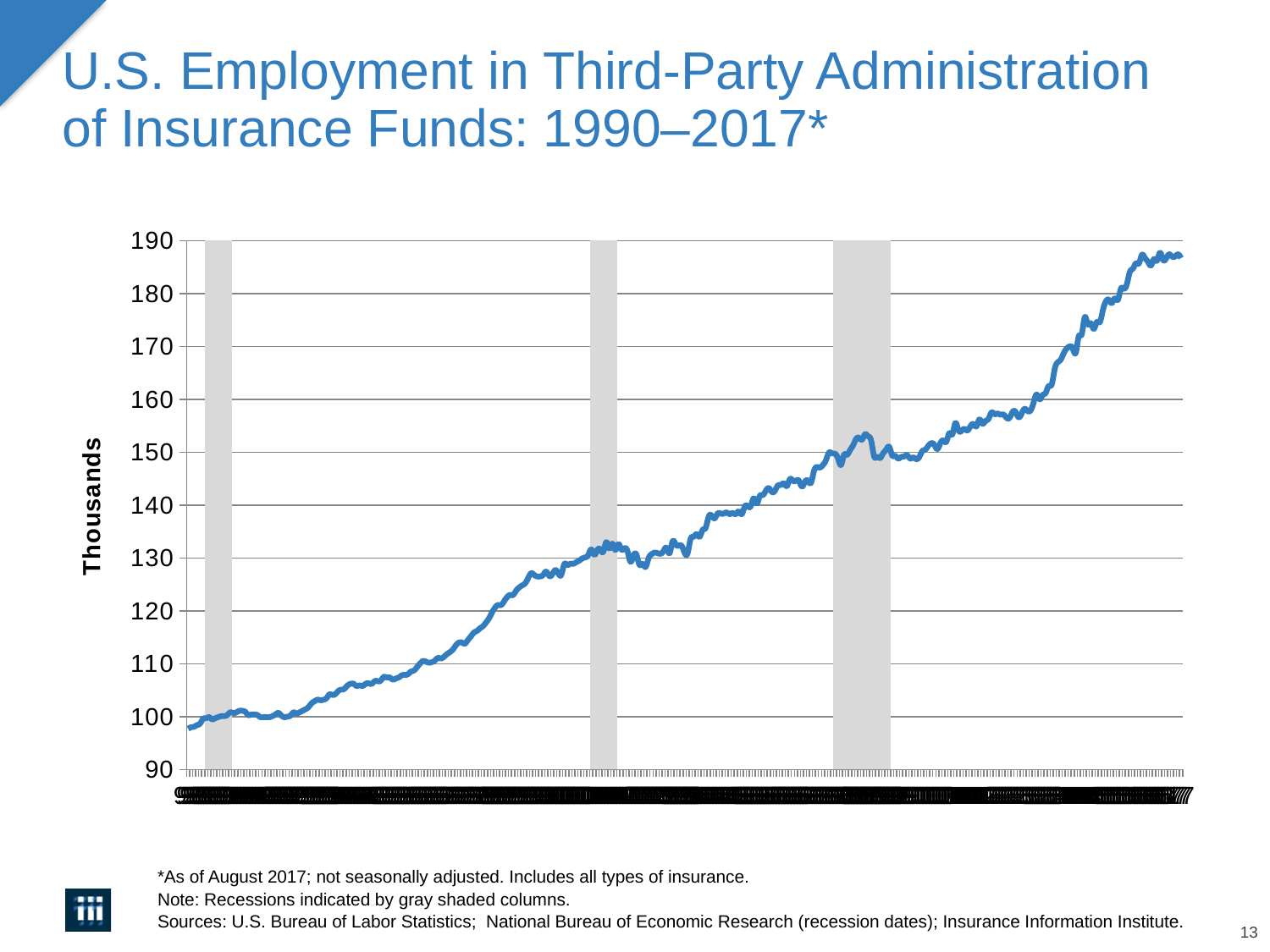
What is the title of the chart? U.S. Employment in Third-Party Administration of Insurance Funds: 1990–2017* Is the highest point on the line greater or less than 190? less Is the value at the end of the series (2017) greater or less than 180? greater What is the highest value shown on the vertical axis? 190 Is the value at the end of the series greater or less than 150? greater What is the label on the vertical axis? Thousands Overall, do the values rise or fall from the start of the series to the end? Rise What kind of chart is shown on the slide? Line chart